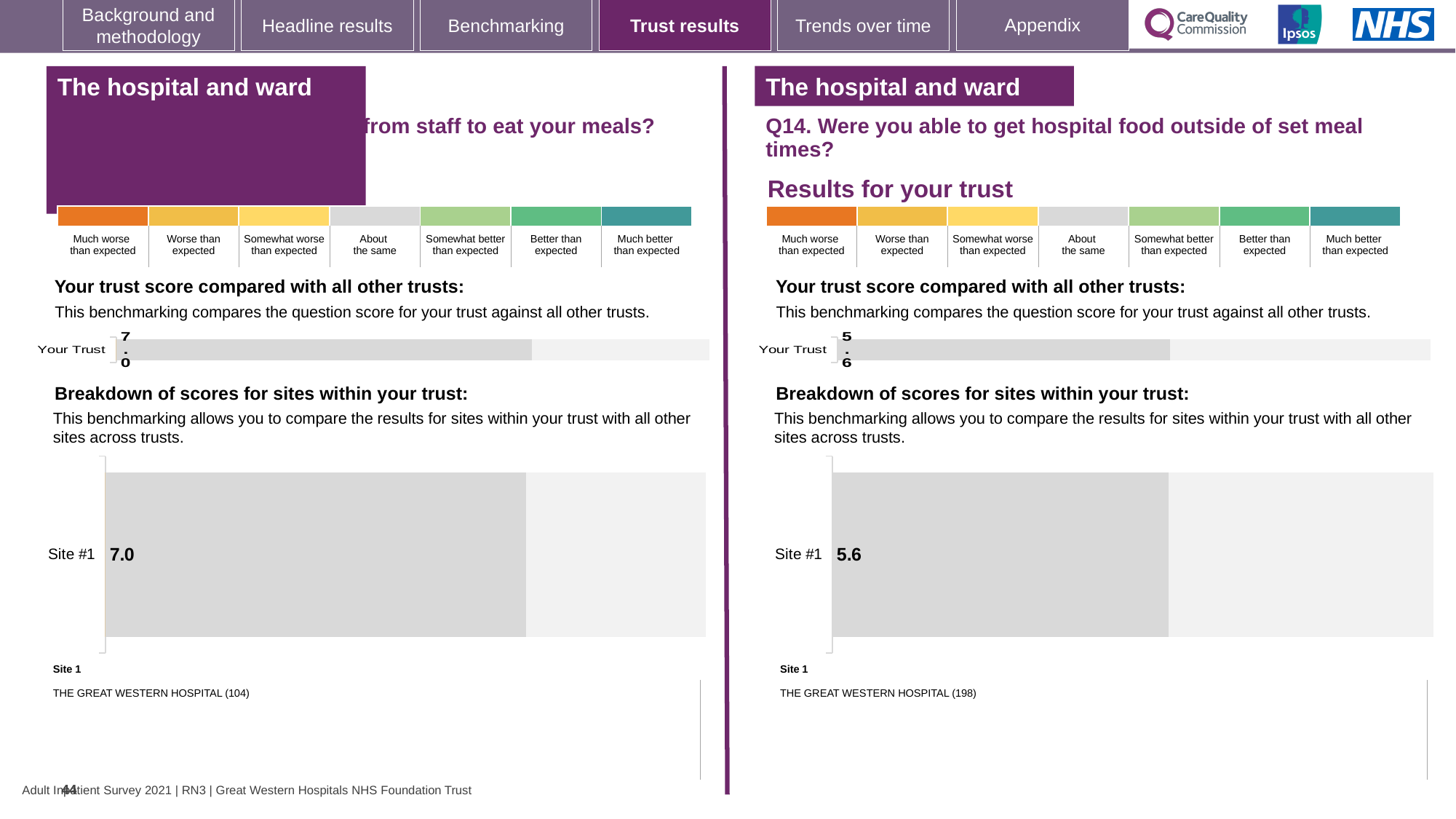
On the left-hand side of the slide, what is the trust score shown in the 'Your trust score compared with all other trusts' chart? 7.0 On the right-hand side of the slide (Q14), what is the trust score shown in the 'Your trust score compared with all other trusts' chart? 5.6 What kind of chart is used to show the Site #1 score in the right-hand (Q14) breakdown section? Bar chart Which is larger: the Site #1 score in the left-hand breakdown chart or the Site #1 score in the right-hand (Q14) breakdown chart? Left-hand chart (7.0) Which site name is listed under 'Site 1' beneath the right-hand (Q14) breakdown chart? THE GREAT WESTERN HOSPITAL (198) What kind of chart is used to show the 'Your Trust' score on the left-hand side of the slide? Bar chart Which site name is listed under 'Site 1' beneath the left-hand breakdown chart? THE GREAT WESTERN HOSPITAL (104) How many sites are shown in the 'Breakdown of scores for sites within your trust' chart on the left-hand side? 1 How many sites are shown in the 'Breakdown of scores for sites within your trust' chart on the right-hand side (Q14)? 1 In the 'Breakdown of scores for sites within your trust' chart on the right-hand side (Q14), what is the score for Site #1? 5.6 In the 'Breakdown of scores for sites within your trust' chart on the left-hand side, what is the score for Site #1? 7.0 What is the difference between the Site #1 score in the left-hand breakdown chart (7.0) and the Site #1 score in the right-hand Q14 breakdown chart (5.6)? 1.4